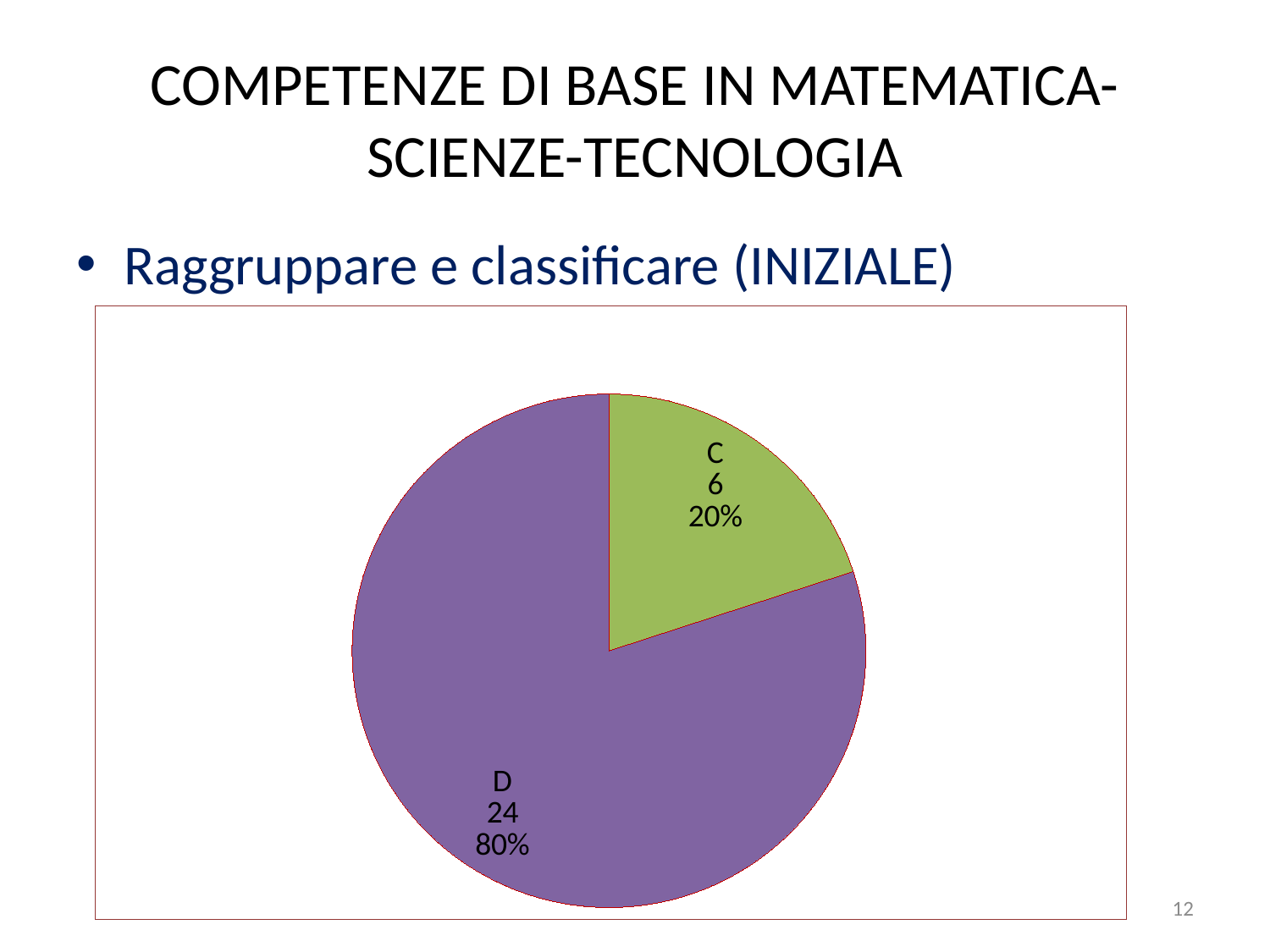
Which slice is the largest? D What share of the pie does slice C represent? 20% Which slice is the smallest? C What is the total of the values shown in the pie chart? 30 Which is larger, the value for C or the value for D? D What is the value for slice C? 6 What colour is the slice labelled D? purple What kind of chart is shown on the slide? pie chart What share of the pie does slice D represent? 80% How many slices does the pie chart have? 2 What is the difference between the values of D and C? 18 What is the value for slice D? 24